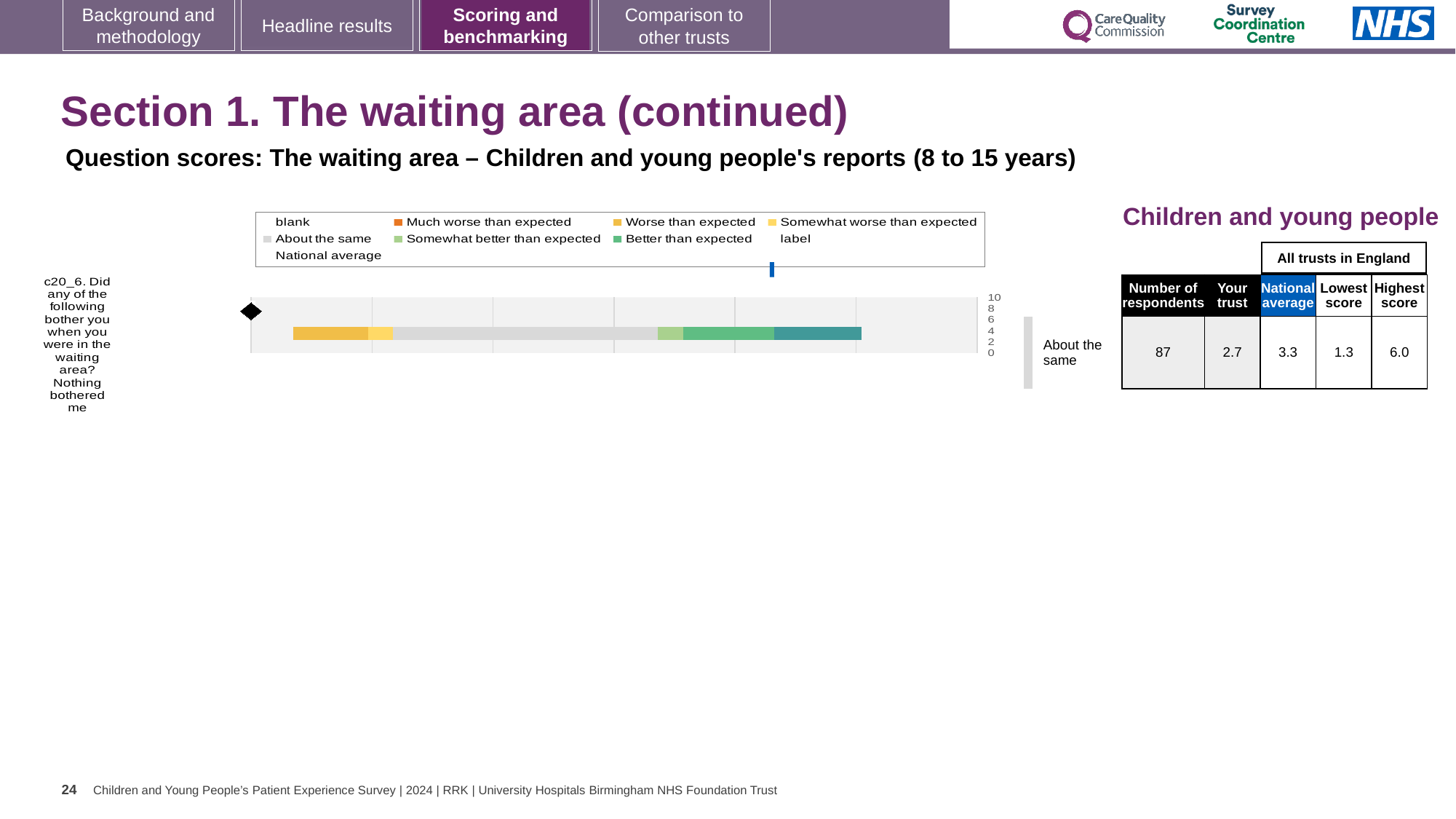
How many questions (categories) are plotted in the chart? 1 What is the highest score among all trusts in England for question c20_6? 6.0 What is the difference between the national average and the trust's score for question c20_6? 0.6 What is the lowest score among all trusts in England for question c20_6? 1.3 What is the national average score for question c20_6? 3.3 How many respondents answered question c20_6? 87 What benchmark category label is shown next to the bar for question c20_6? About the same Is the trust's score for question c20_6 greater or less than 4? less What kind of chart is shown on the slide? bar chart What is the difference between the highest and lowest scores among all trusts in England for question c20_6? 4.7 What is the 'Your trust' score for question c20_6? 2.7 Which is larger for question c20_6: the trust's score or the national average? national average